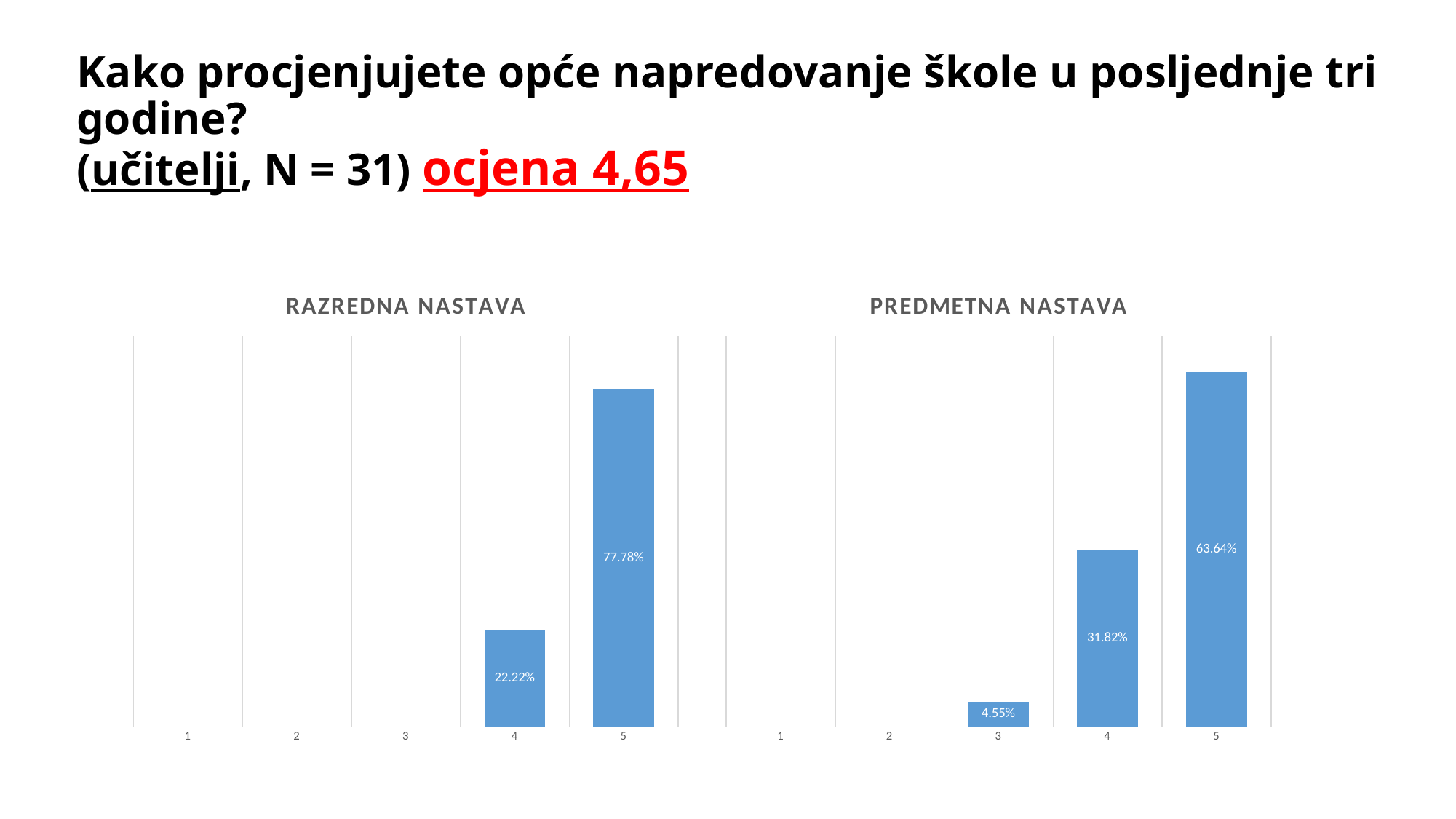
In the RAZREDNA NASTAVA chart, what is the value for category 4? 22.22% In the PREDMETNA NASTAVA chart, what is the difference between the values for category 5 and category 4? 31.82% What kind of chart is the PREDMETNA NASTAVA chart? bar chart In the RAZREDNA NASTAVA chart, what is the difference between the values for category 5 and category 4? 55.56% What is the title of the chart on the left side of the slide? RAZREDNA NASTAVA In the PREDMETNA NASTAVA chart, which category has the highest value? 5 How many categories are shown on the x axis of the RAZREDNA NASTAVA chart? 5 In the RAZREDNA NASTAVA chart, what is the value for category 5? 77.78% In the PREDMETNA NASTAVA chart, what is the value for category 5? 63.64% In the PREDMETNA NASTAVA chart, which is larger, the value for category 3 or the value for category 4? category 4 In the PREDMETNA NASTAVA chart, what is the value for category 4? 31.82% In the PREDMETNA NASTAVA chart, what is the value for category 3? 4.55%